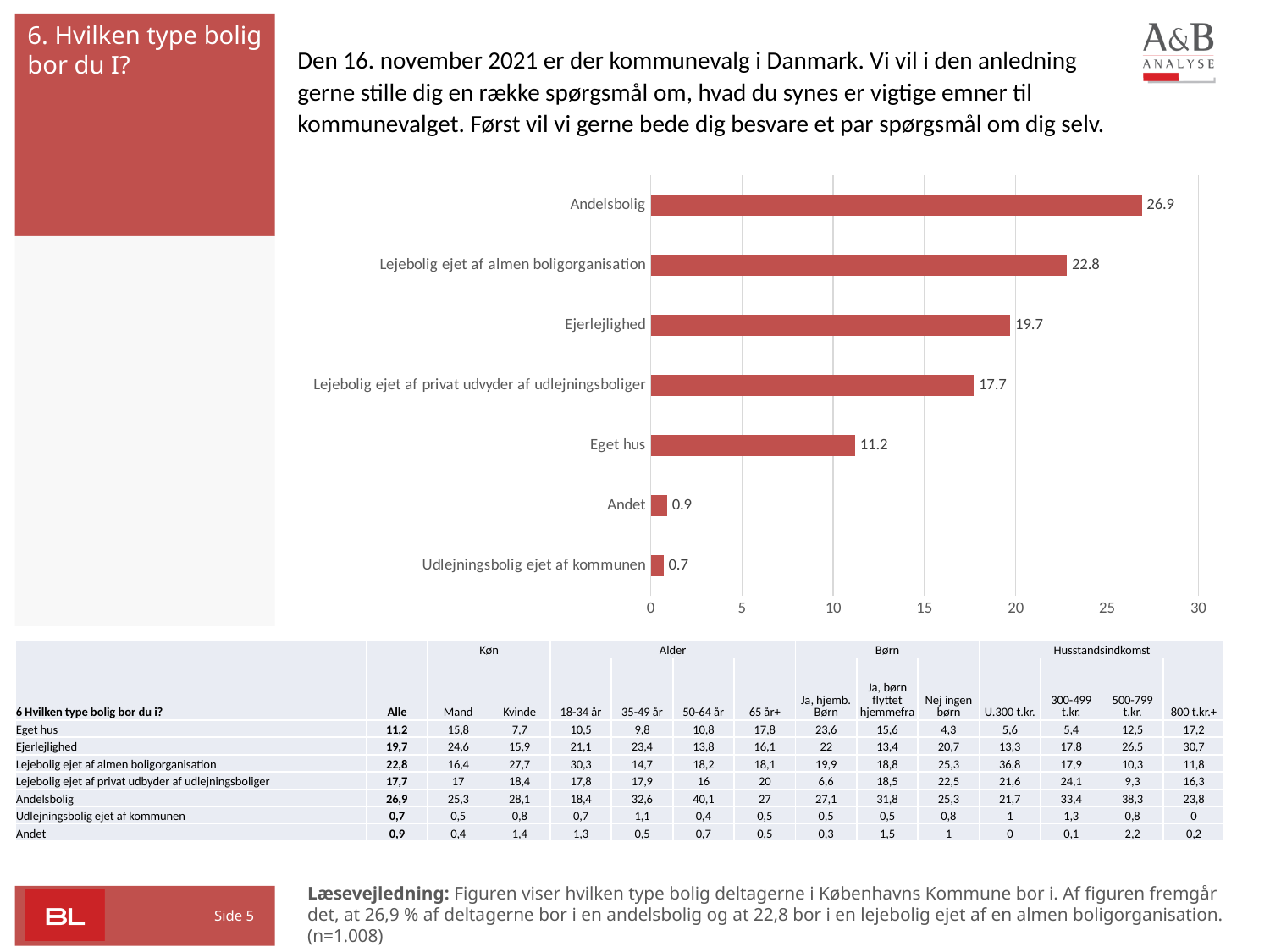
Is the value for Lejebolig ejet af almen boligorganisation greater or less than 20? greater What is the value for Ejerlejlighed in the bar chart? 19.7 What is the difference between the values for Andet and Udlejningsbolig ejet af kommunen? 0.2 What is the value for Eget hus in the bar chart? 11.2 What is the value for Udlejningsbolig ejet af kommunen in the bar chart? 0.7 Which category has the highest value in the bar chart? Andelsbolig What is the difference between the values for Andelsbolig and Lejebolig ejet af almen boligorganisation? 4.1 Which is larger in the bar chart: Ejerlejlighed or Lejebolig ejet af privat udvyder af udlejningsboliger? Ejerlejlighed How many categories are shown in the bar chart? 7 Which category has the lowest value in the bar chart? Udlejningsbolig ejet af kommunen What is the value for Andelsbolig in the bar chart? 26.9 What kind of chart is shown on the slide? Bar chart